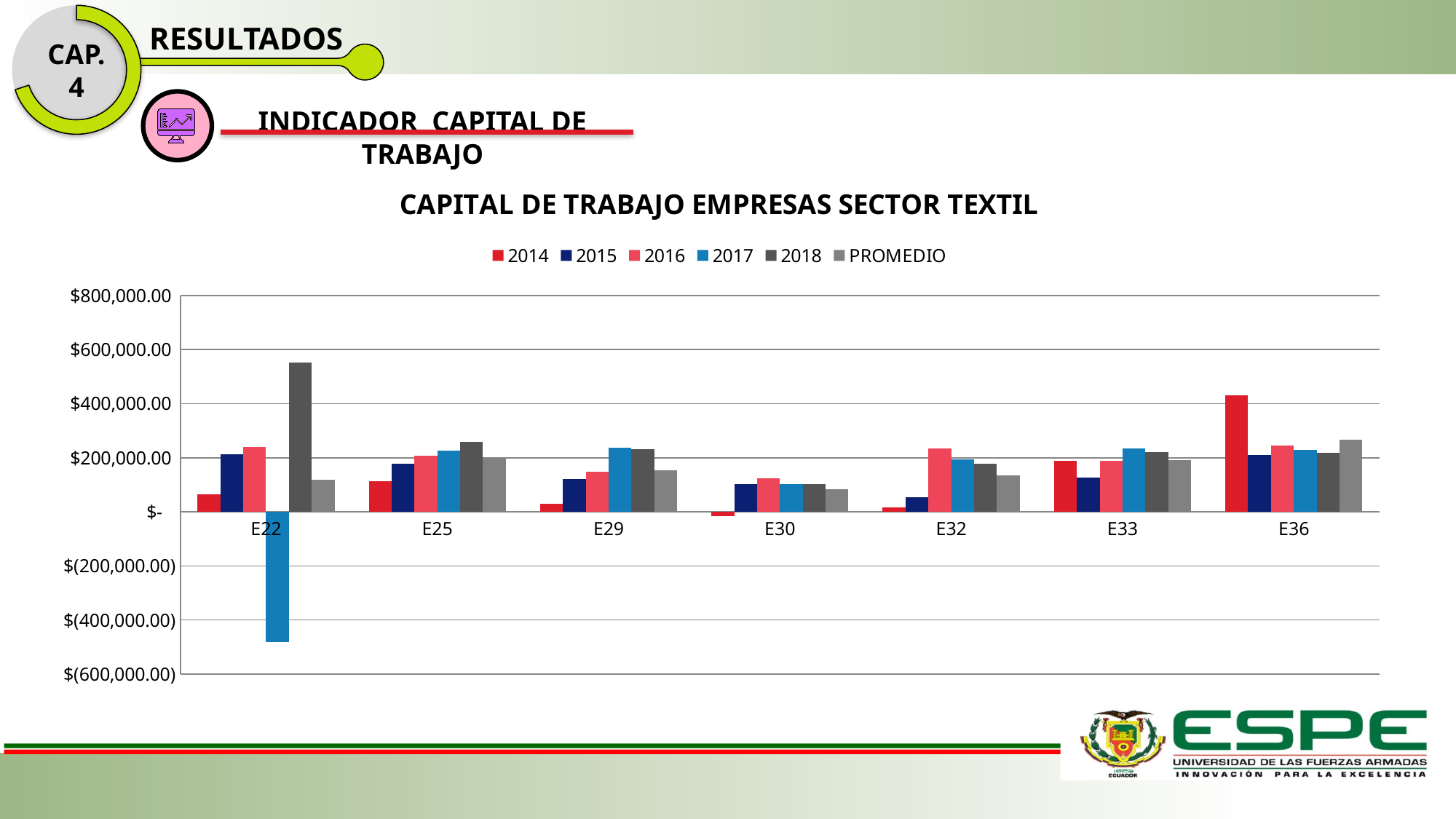
Which company has the highest PROMEDIO value? E36 Which company has the lowest value for 2017? E22 Is the 2018 value for E22 greater or less than $400,000.00? greater What is the title of the chart? CAPITAL DE TRABAJO EMPRESAS SECTOR TEXTIL Which company has the highest value for 2014? E36 Which company has the highest value for 2018? E22 Is the 2017 value for E22 greater or less than $(400,000.00)? less How many companies (categories) are shown on the x axis? 7 Which is larger: the 2018 value for E22 or the 2014 value for E36? the 2018 value for E22 What kind of chart is shown on the slide? bar chart How many series does the legend list? 6 Which company has the lowest value for 2014? E30